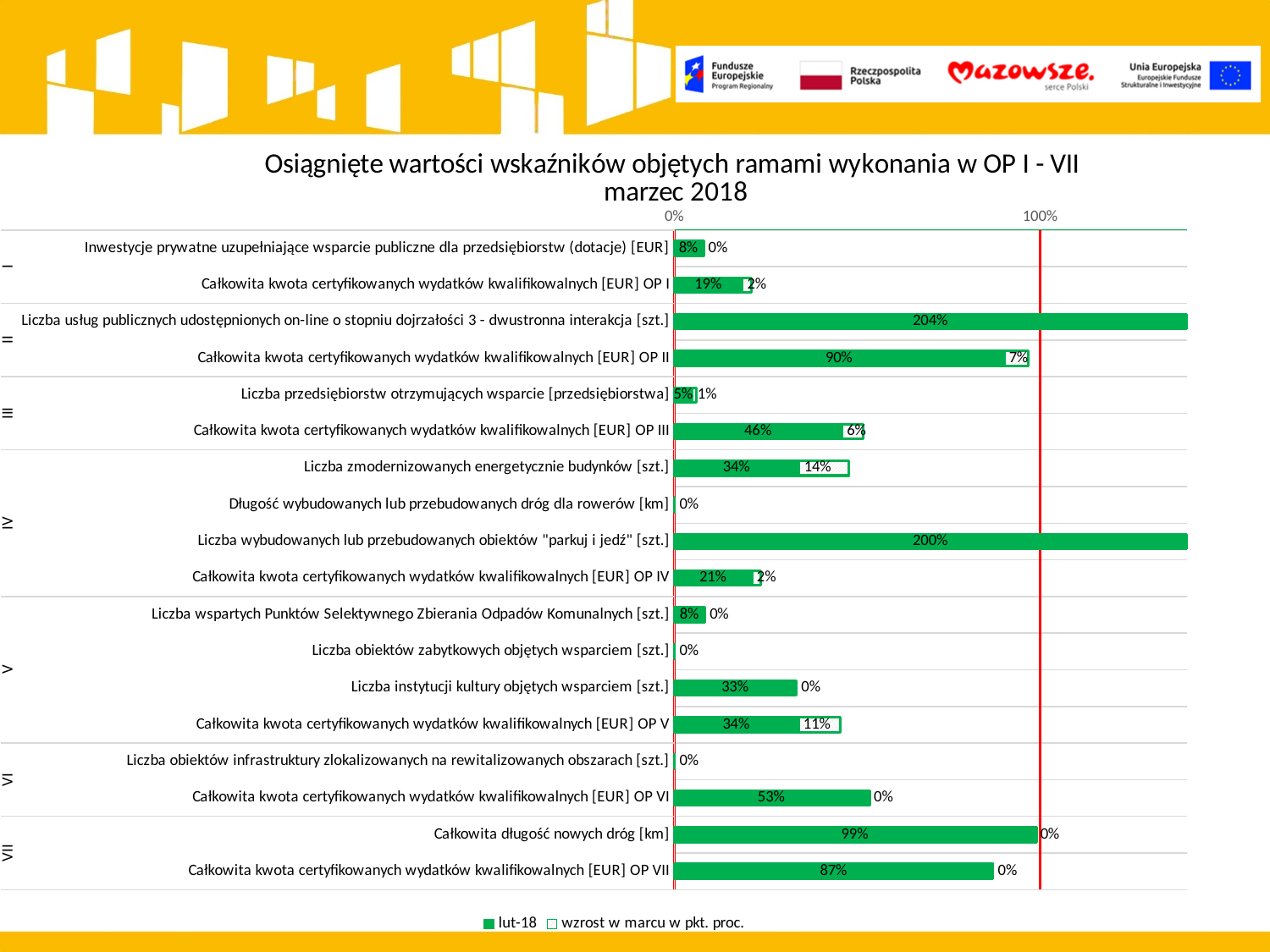
How many indicator categories are plotted on the chart? 18 Which has a larger lut-18 value: "Całkowita kwota certyfikowanych wydatków kwalifikowalnych [EUR] OP III" or "Całkowita kwota certyfikowanych wydatków kwalifikowalnych [EUR] OP IV"? Całkowita kwota certyfikowanych wydatków kwalifikowalnych [EUR] OP III What is the lut-18 value for "Całkowita kwota certyfikowanych wydatków kwalifikowalnych [EUR] OP II"? 90% What kind of chart is shown on the slide? bar chart What is the total of the stacked bar for "Całkowita kwota certyfikowanych wydatków kwalifikowalnych [EUR] OP V"? 45% What is the title of the chart? Osiągnięte wartości wskaźników objętych ramami wykonania w OP I - VII marzec 2018 Which category has the highest lut-18 value? Liczba usług publicznych udostępnionych on-line o stopniu dojrzałości 3 - dwustronna interakcja [szt.] What is the "wzrost w marcu w pkt. proc." value for "Liczba zmodernizowanych energetycznie budynków [szt.]"? 14% What is the difference between the lut-18 values for "Całkowita kwota certyfikowanych wydatków kwalifikowalnych [EUR] OP VII" and "Całkowita kwota certyfikowanych wydatków kwalifikowalnych [EUR] OP VI"? 34% How many series does the legend list? 2 What is the lut-18 value for "Całkowita długość nowych dróg [km]"? 99%